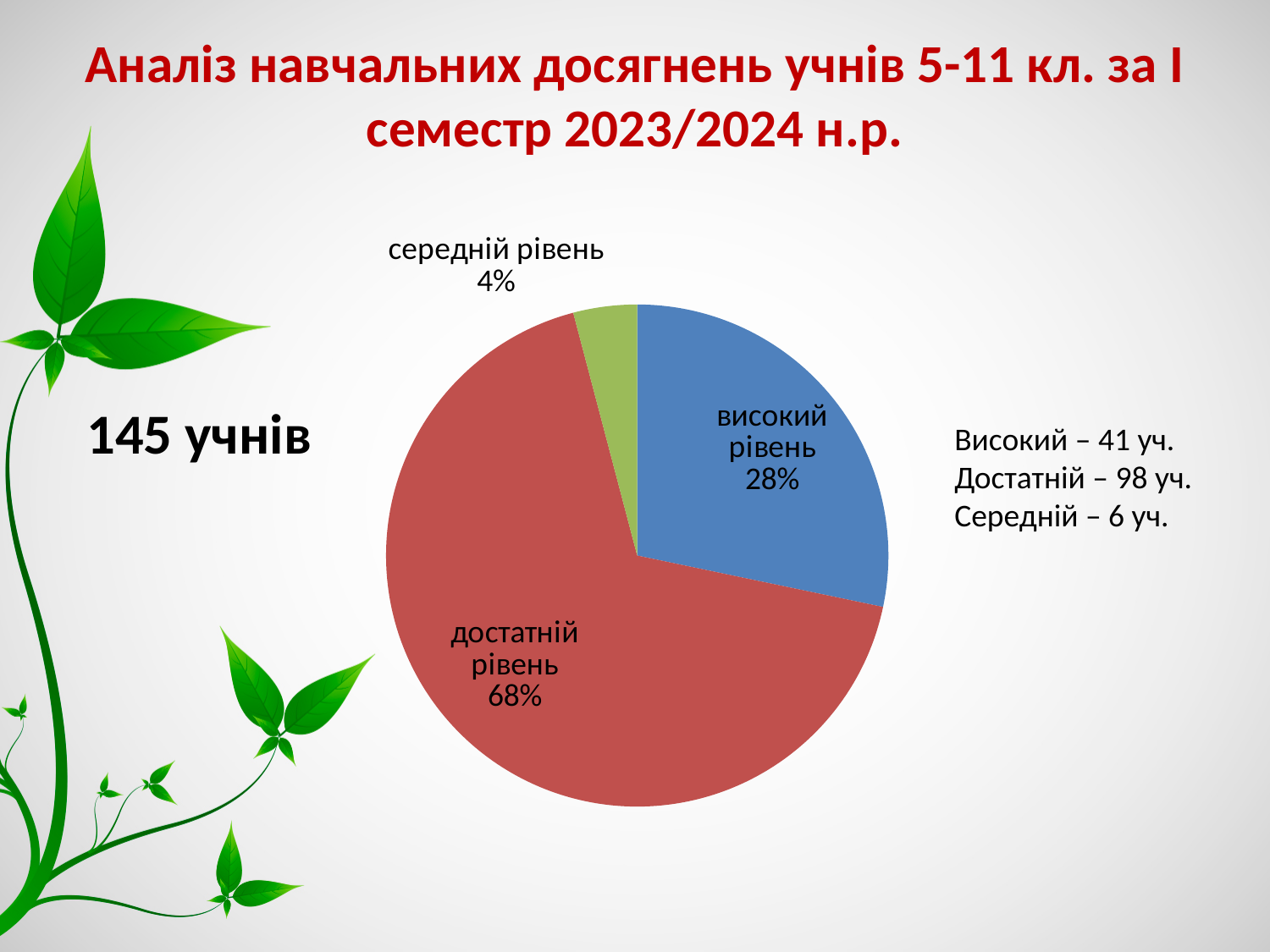
What kind of chart is shown on the slide? pie chart What colour is the "достатній рівень" slice of the pie? red What colour is the "високий рівень" slice of the pie? blue What percentage of the pie is labelled "середній рівень"? 4% What percentage of the pie is labelled "достатній рівень"? 68% What is the difference in percentage points between the "достатній рівень" slice and the "високий рівень" slice? 40 How many slices does the pie chart have? 3 Which slice of the pie is the largest? достатній рівень Which slice of the pie is the smallest? середній рівень What percentage of the pie is labelled "високий рівень"? 28% What is the difference in percentage points between the "високий рівень" slice and the "середній рівень" slice? 24 Which is larger, the share for "високий рівень" or the share for "середній рівень"? високий рівень